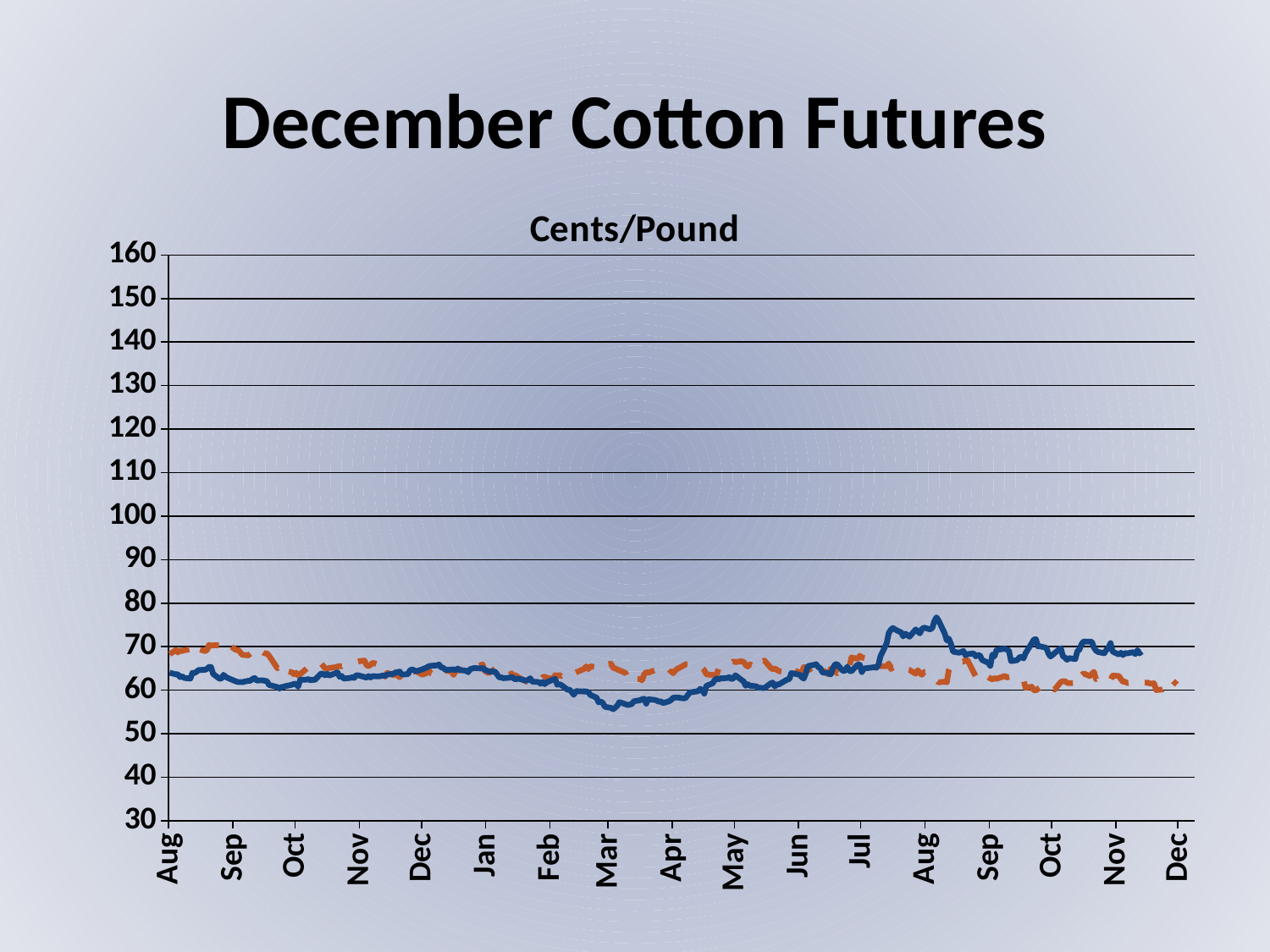
Is the value of the dashed orange line at its end near Dec greater or less than 70? less What kind of chart is shown on the slide? line chart How many lines are plotted on the chart? 2 Is the peak of the solid blue line, reached around the second Aug, greater or less than 70? greater Is the lowest point of the solid blue line, around Mar, greater or less than 60? less Around which month does the solid blue line reach its highest value? Aug Around which month does the solid blue line reach its lowest value? Mar Around Mar, which line is higher, the solid blue line or the dashed orange line? dashed orange line Does the solid blue line rise or fall between Feb and Mar? fall What is the highest value shown on the y axis? 160 How many month labels are shown along the x axis? 17 What is the title shown above the chart's plot area? Cents/Pound